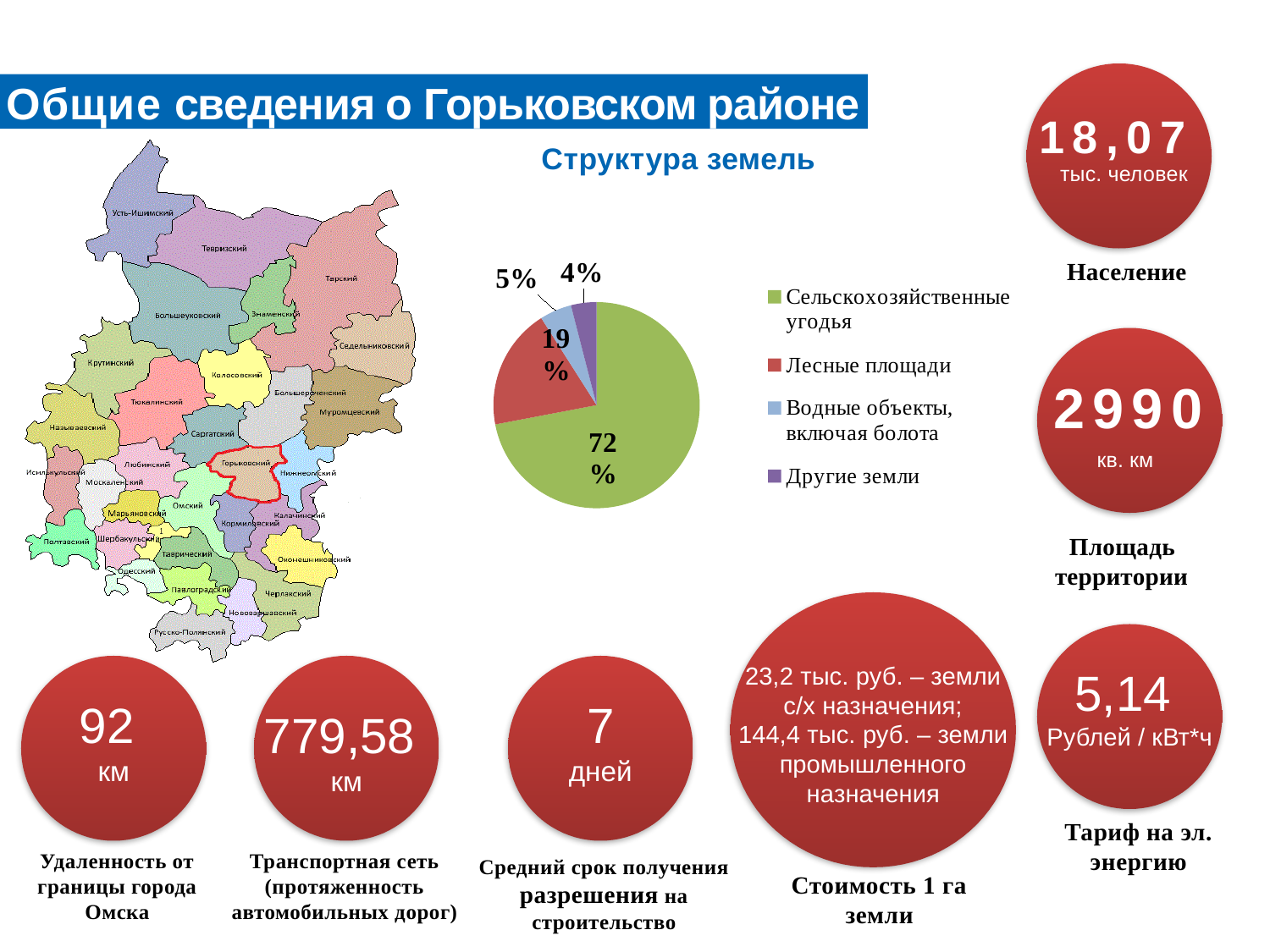
In the "Структура земель" pie chart, what share is labelled for "Водные объекты, включая болота"? 5% In the "Структура земель" pie chart, what is the difference in percentage points between "Сельскохозяйственные угодья" and "Лесные площади"? 53 How many slices does the "Структура земель" pie chart have? 4 In the "Структура земель" pie chart, what share is labelled for "Лесные площади"? 19% In the "Структура земель" pie chart, what share is labelled for "Другие земли"? 4% Which category has the smallest slice in the "Структура земель" pie chart? Другие земли In the "Структура земель" pie chart, which is larger: "Лесные площади" or "Водные объекты, включая болота"? Лесные площади In the "Структура земель" pie chart, what share is labelled for "Сельскохозяйственные угодья"? 72% Which category has the largest slice in the "Структура земель" pie chart? Сельскохозяйственные угодья How many entries does the legend of the "Структура земель" pie chart list? 4 What kind of chart is shown under the heading "Структура земель"? pie chart In the "Структура земель" pie chart, what colour is the slice for "Лесные площади"? red